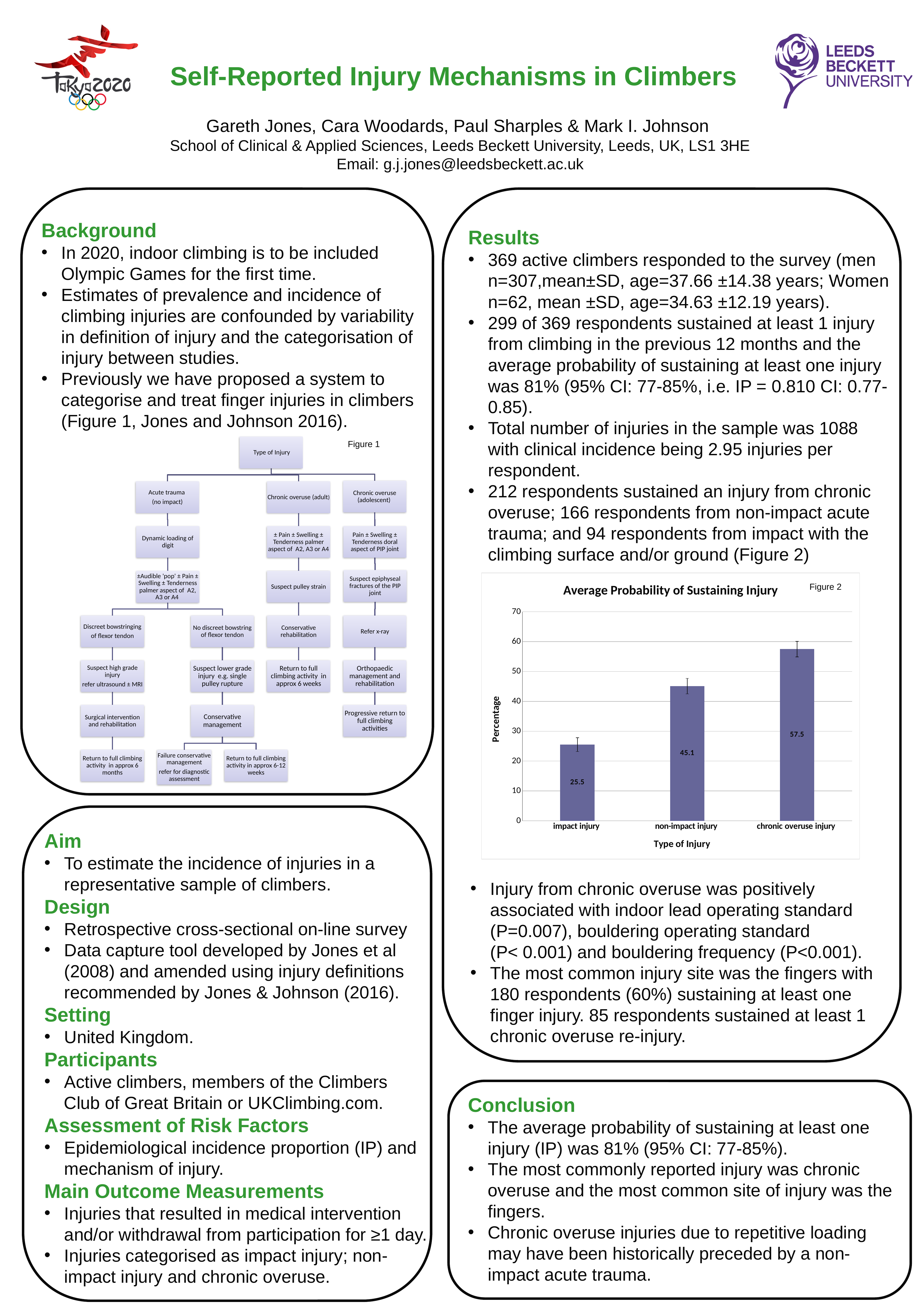
What is the value for non-impact injury in the Average Probability of Sustaining Injury chart? 45.1 What is the difference between the values for chronic overuse injury and impact injury in the chart? 32 Is the value for chronic overuse injury greater or less than 50? greater What is the value for chronic overuse injury in the Average Probability of Sustaining Injury chart? 57.5 What kind of chart is Figure 2? bar chart How many types of injury are plotted in the Average Probability of Sustaining Injury chart? 3 Which is larger in the chart: the value for non-impact injury or the value for impact injury? non-impact injury Which type of injury has the highest average probability in the chart? chronic overuse injury What is the label of the y axis in the Average Probability of Sustaining Injury chart? Percentage Which type of injury has the lowest average probability in the chart? impact injury What is the difference between the values for non-impact injury and impact injury in the chart? 19.6 What is the value for impact injury in the Average Probability of Sustaining Injury chart? 25.5